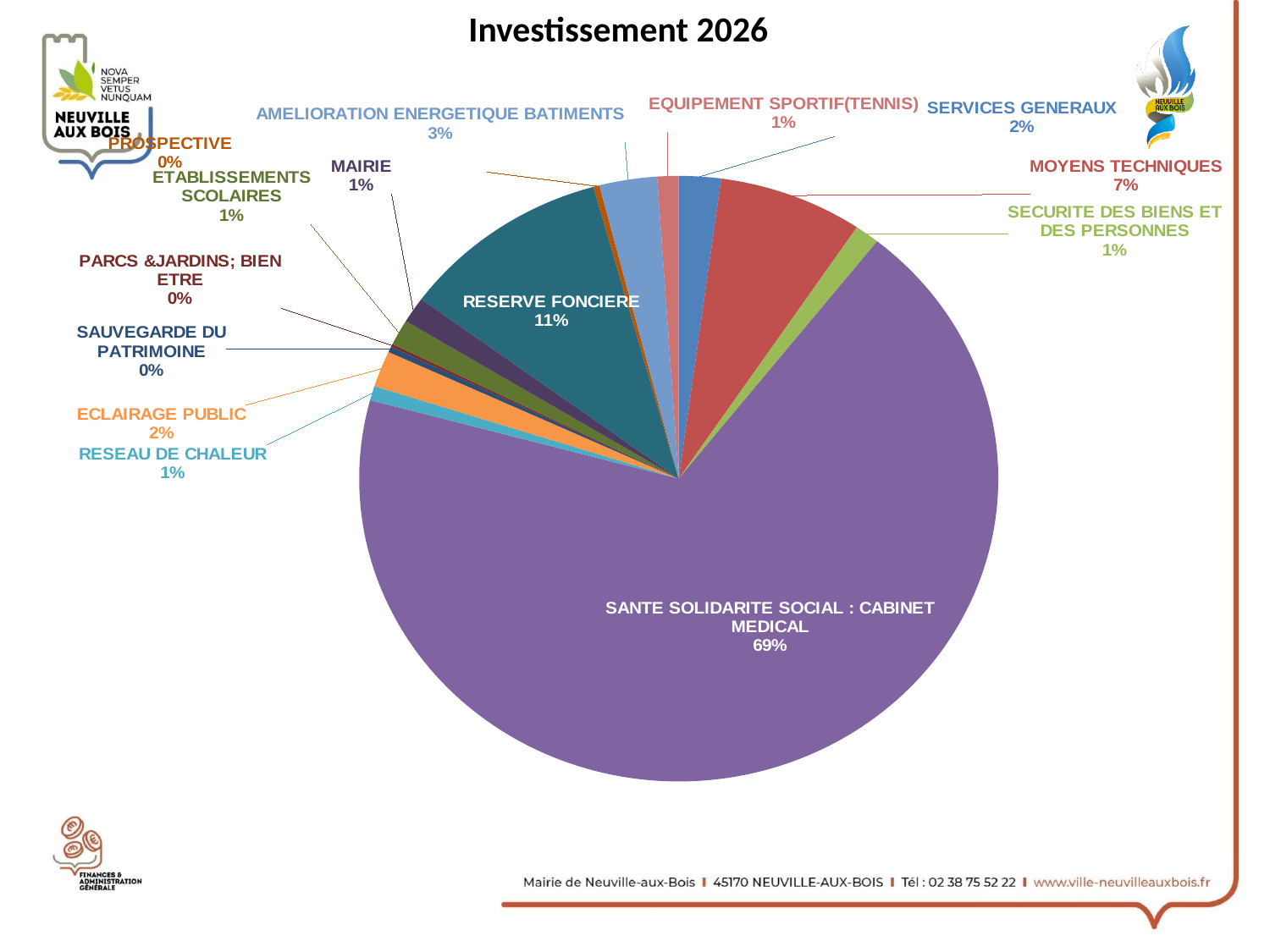
What is the value shown for PROSPECTIVE? 0% What is the difference in percentage points between SANTE SOLIDARITE SOCIAL : CABINET MEDICAL and RESERVE FONCIERE? 58 Which is larger, the slice for MOYENS TECHNIQUES or the slice for SERVICES GENERAUX? MOYENS TECHNIQUES How many categories are shown in the pie chart? 14 What kind of chart is shown on the slide? pie chart What is the title of the chart? Investissement 2026 What is the value shown for ECLAIRAGE PUBLIC? 2% What is the value shown for AMELIORATION ENERGETIQUE BATIMENTS? 3% What share of the pie does SANTE SOLIDARITE SOCIAL : CABINET MEDICAL represent? 69% What share of the pie does RESERVE FONCIERE represent? 11% What is the value shown for MOYENS TECHNIQUES? 7% Which category has the largest slice of the pie? SANTE SOLIDARITE SOCIAL : CABINET MEDICAL